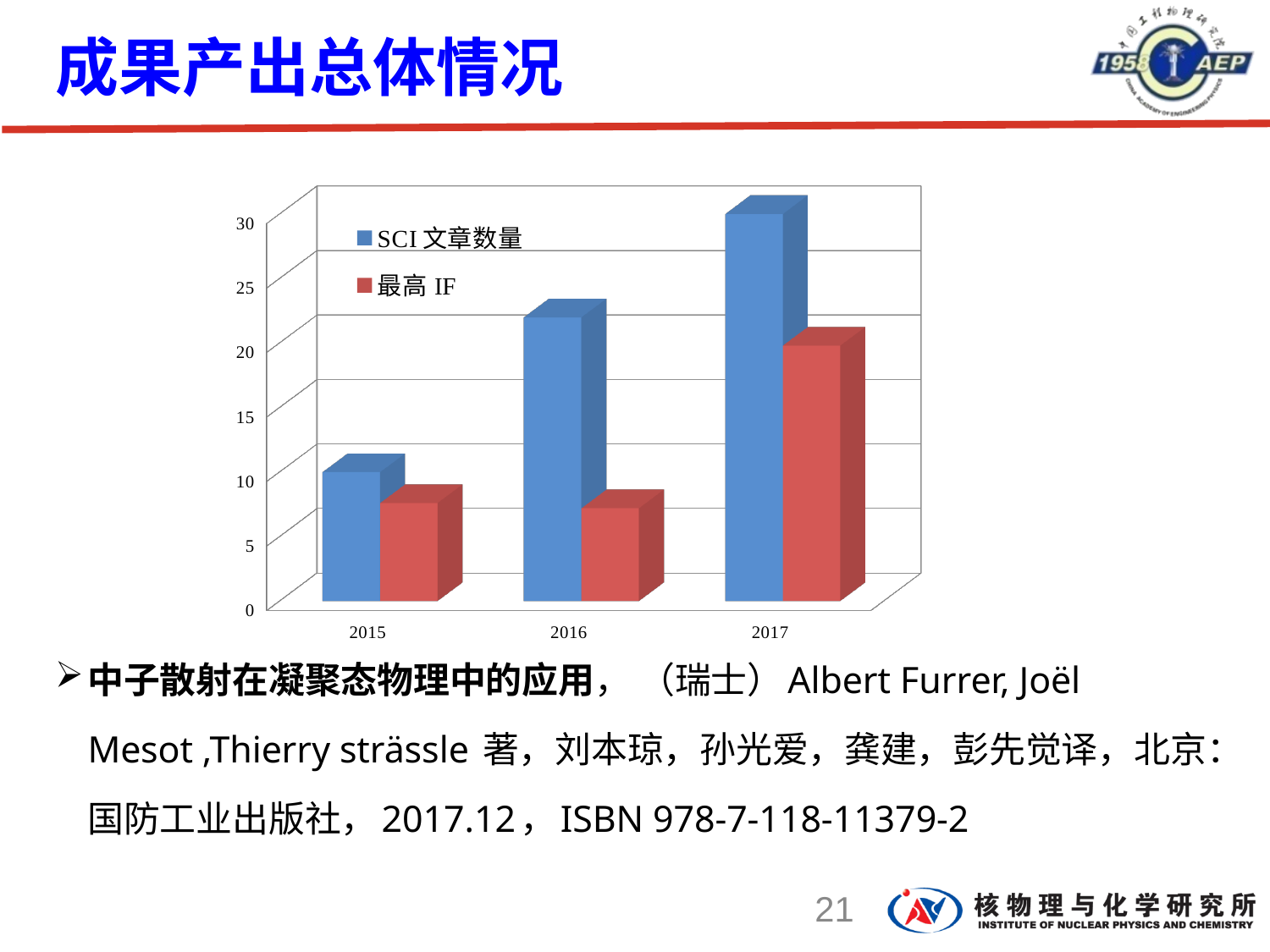
Do the values for SCI 文章数量 rise or fall from 2015 to 2017? rise In 2016, which is larger: SCI 文章数量 or 最高 IF? SCI 文章数量 Is the value for SCI 文章数量 in 2016 greater or less than 20? greater Is the value for 最高 IF in 2017 greater or less than 15? greater Is the value for 最高 IF in 2016 greater or less than 10? less What kind of chart is shown on the slide? bar chart How many series does the chart legend list? 2 Which year has the highest value for 最高 IF? 2017 Which year has the lowest value for SCI 文章数量? 2015 How many years are shown on the x axis of the chart? 3 Which year has the highest value for SCI 文章数量? 2017